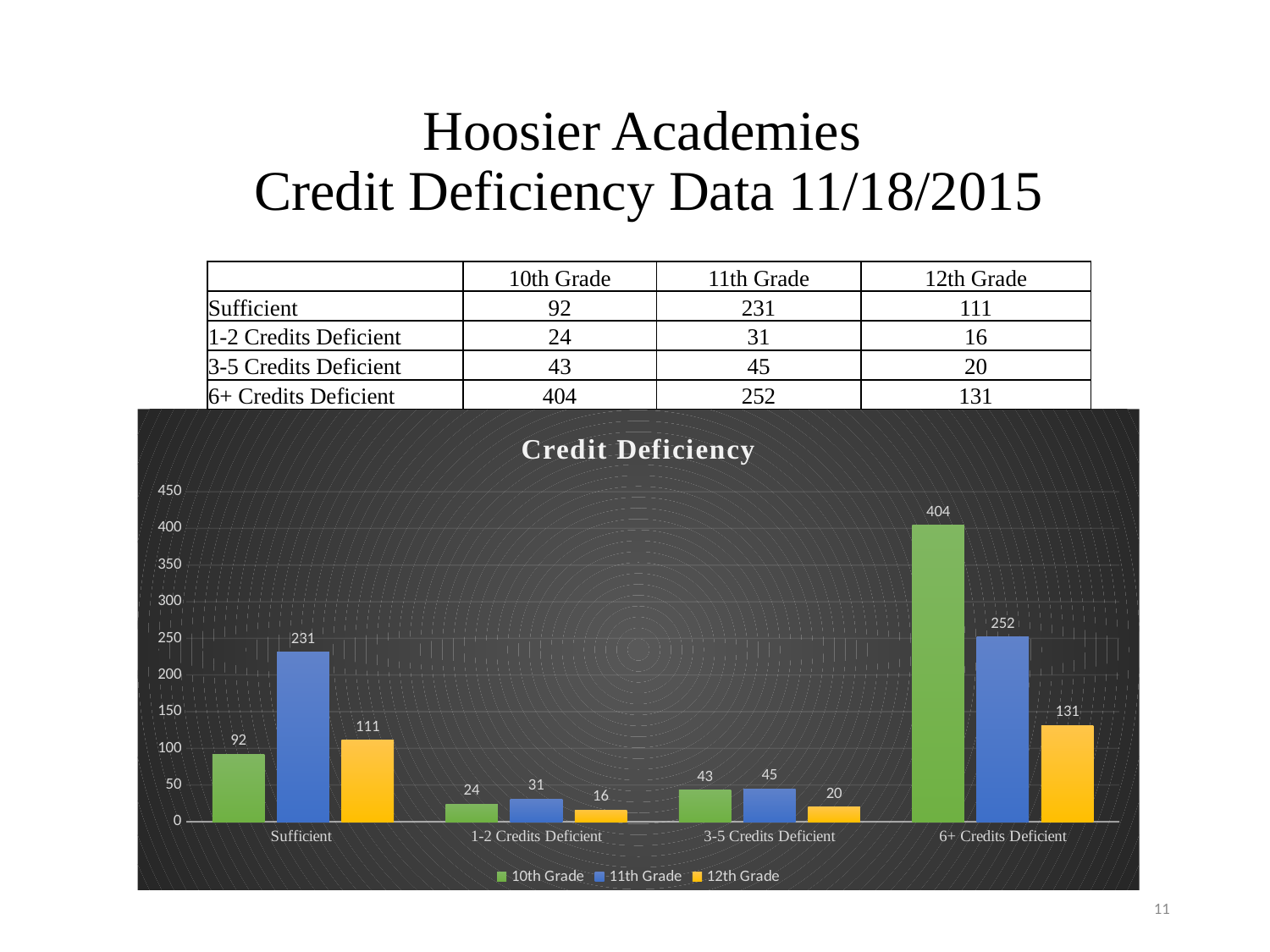
What is the title of the chart? Credit Deficiency How many series does the legend list? 3 What is the value for 10th Grade in the 6+ Credits Deficient category? 404 Which category has the highest value for 10th Grade? 6+ Credits Deficient What is the difference between the 10th Grade and 11th Grade values in the 6+ Credits Deficient category? 152 What is the value for 11th Grade in the Sufficient category? 231 What is the value for 12th Grade in the 1-2 Credits Deficient category? 16 Which category has the lowest value for 12th Grade? 1-2 Credits Deficient Is the value for 12th Grade in the 6+ Credits Deficient category greater or less than 100? greater Which is larger in the Sufficient category, the 11th Grade value or the 12th Grade value? 11th Grade What kind of chart is shown? bar chart How many categories are shown on the x axis? 4